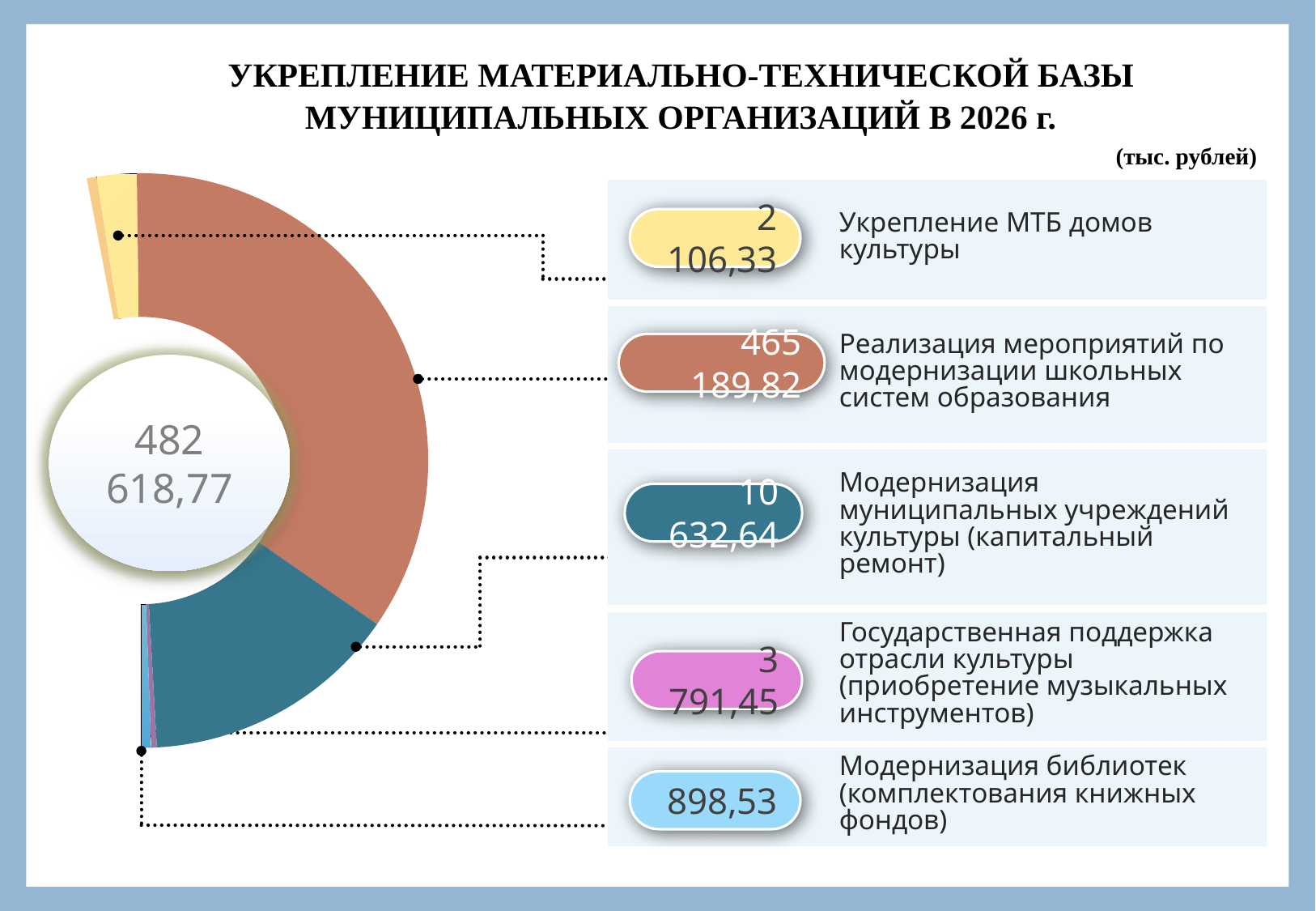
Which is larger: the value for «Модернизация муниципальных учреждений культуры (капитальный ремонт)» or for «Государственная поддержка отрасли культуры (приобретение музыкальных инструментов)»? Модернизация муниципальных учреждений культуры (капитальный ремонт) What is the value for «Модернизация библиотек (комплектования книжных фондов)»? 898,53 How many categories does the chart show? 5 What is the value for «Укрепление МТБ домов культуры»? 2 106,33 What kind of chart is shown on the slide? pie chart (donut) What is the value for «Модернизация муниципальных учреждений культуры (капитальный ремонт)»? 10 632,64 What is the difference between the values for «Реализация мероприятий по модернизации школьных систем образования» and «Модернизация муниципальных учреждений культуры (капитальный ремонт)»? 454 557,18 What is the value for «Реализация мероприятий по модернизации школьных систем образования»? 465 189,82 In what units are the values on the chart given? тыс. рублей What total is shown in the centre of the chart? 482 618,77 Which category has the largest value? Реализация мероприятий по модернизации школьных систем образования Which category has the smallest value? Модернизация библиотек (комплектования книжных фондов)